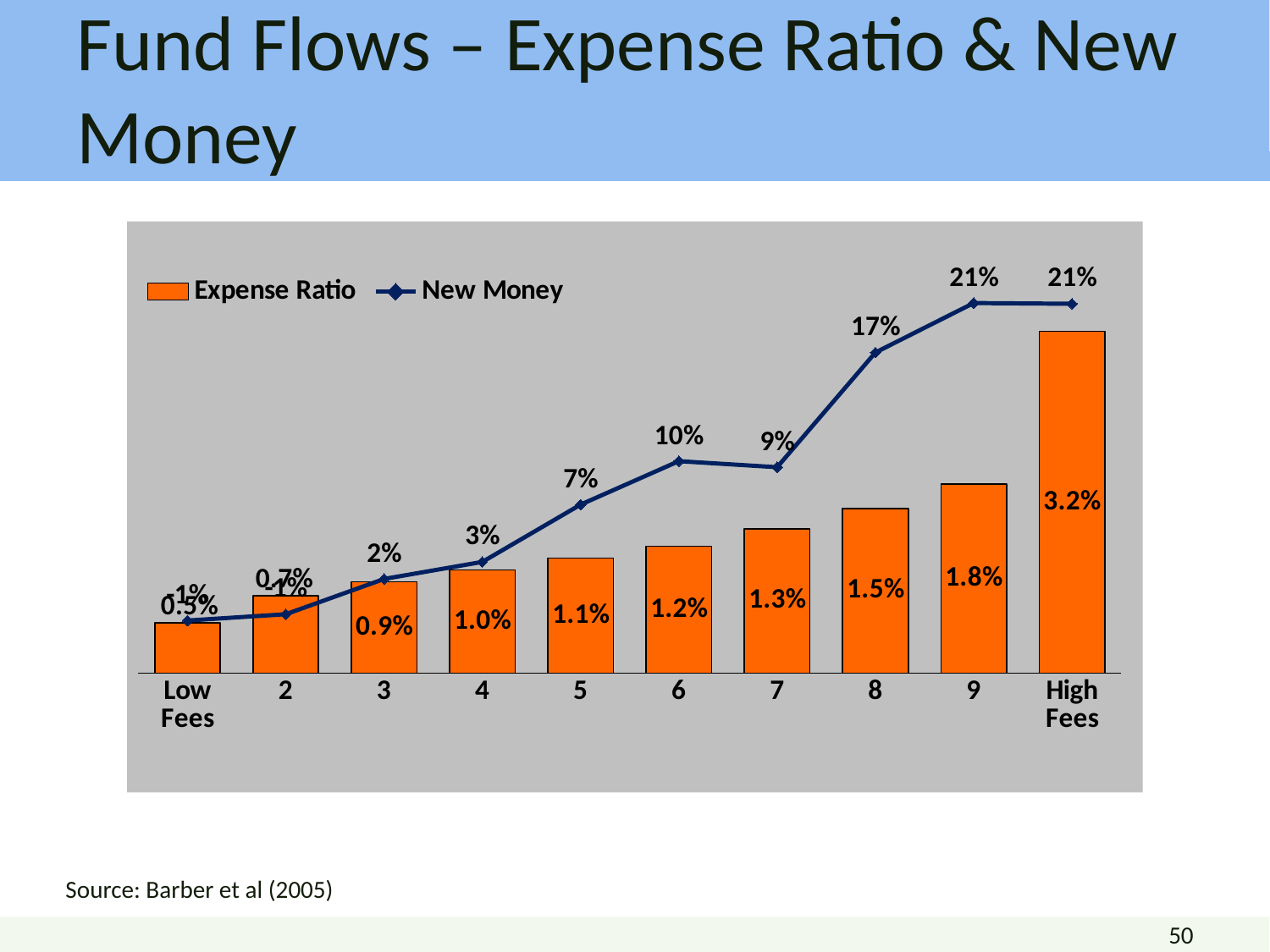
What is the Expense Ratio for the High Fees category? 3.2% What is the difference in New Money between category 8 and category 7? 8% How many series does the legend list? 2 What is the Expense Ratio for category 5? 1.1% Which category has the highest Expense Ratio? High Fees Which category has the lowest Expense Ratio? Low Fees Does the Expense Ratio rise or fall from Low Fees to High Fees? rise What is the New Money value for category 6? 10% What is the difference in Expense Ratio between High Fees and category 9? 1.4% Which has a higher New Money value, category 6 or category 7? category 6 How many categories are shown on the x axis? 10 What is the New Money value for category 8? 17%